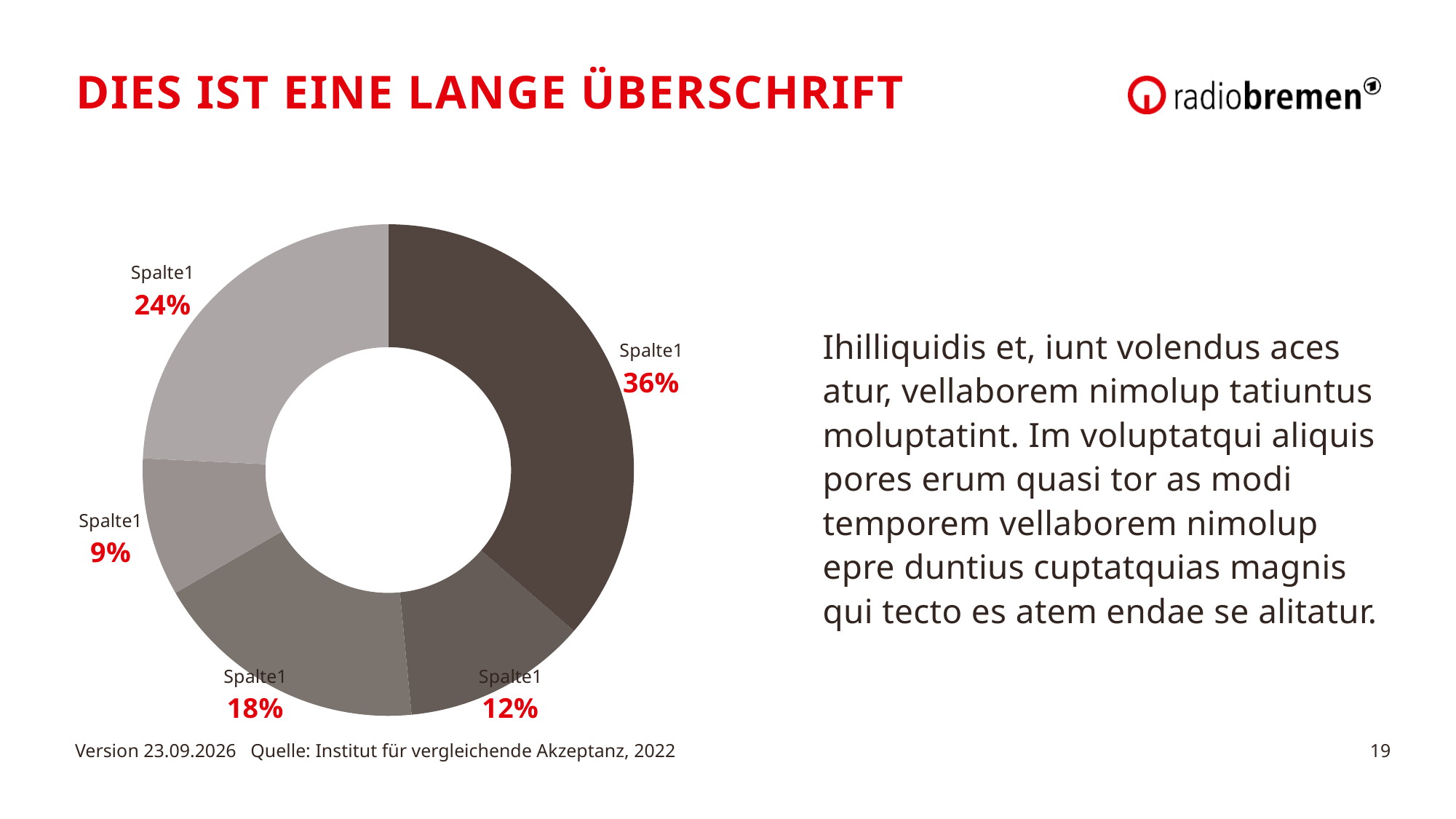
What source is cited at the bottom of the slide? Institut für vergleichende Akzeptanz, 2022 What value is shown for the slice at the bottom right of the doughnut chart? 12% What share of the doughnut does the largest slice represent? 36% What is the value of the smallest slice in the doughnut chart? 9% What label text is shown next to every slice of the doughnut chart? Spalte1 Which is larger: the bottom-left slice or the bottom-right slice? the bottom-left slice (18%) What value is shown for the lightest slice at the top left of the doughnut chart? 24% What is the value of the largest slice in the doughnut chart? 36% What kind of chart is shown on the slide? doughnut (pie) chart How many slices does the doughnut chart have? 5 What is the difference between the largest slice (36%) and the top-left slice (24%)? 12 percentage points What value is shown for the darkest slice on the right side of the doughnut chart? 36%